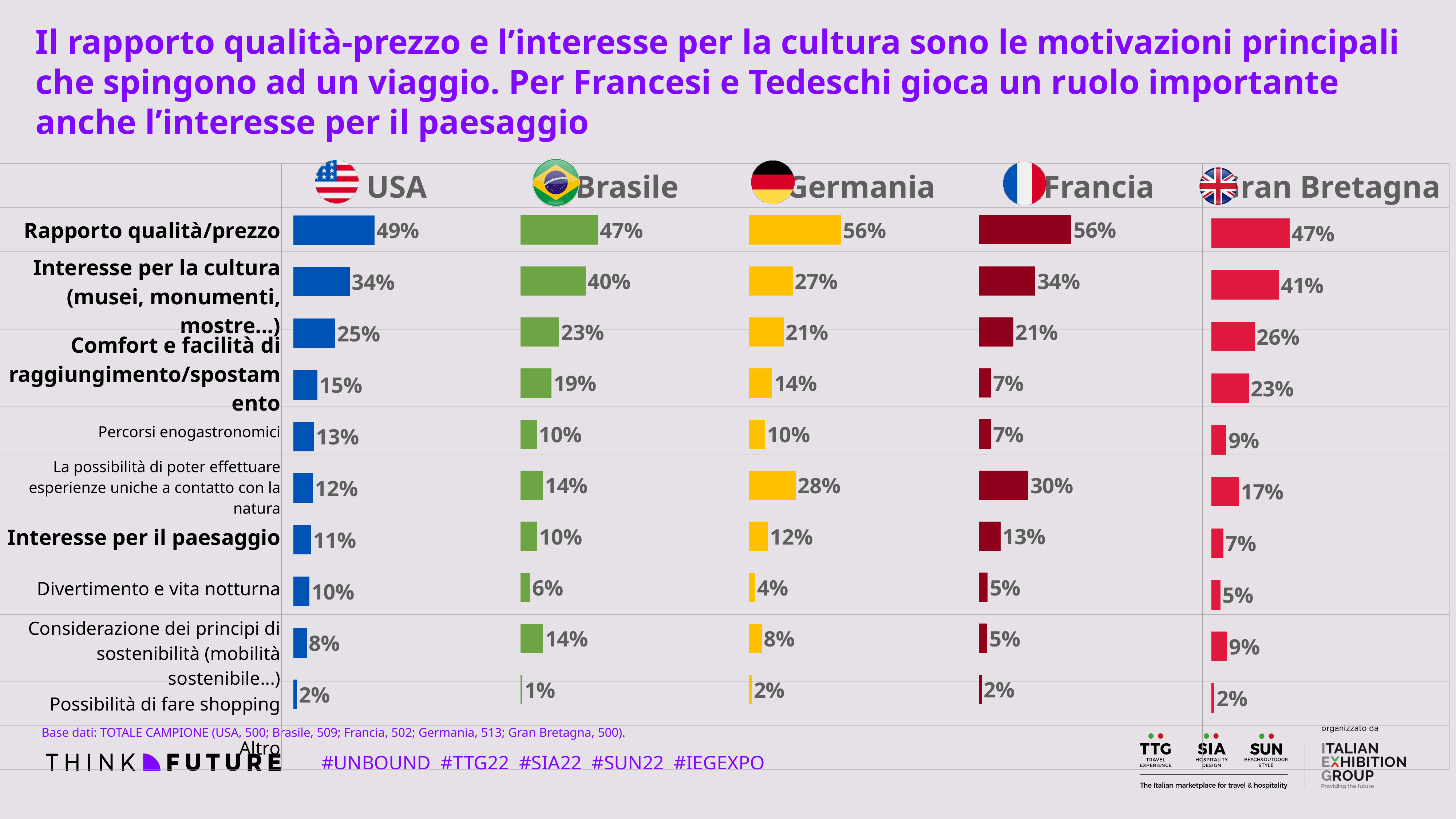
In the USA chart, what is the value for Rapporto qualità/prezzo? 49% In the Francia chart, what is the difference between Rapporto qualità/prezzo and Interesse per la cultura? 22 percentage points How many bars does the USA chart contain? 10 In the Gran Bretagna chart, what is the value for Interesse per la cultura (musei, monumenti, mostre…)? 41% In the Brasile chart, what is the value for Interesse per la cultura (musei, monumenti, mostre…)? 40% For Interesse per la cultura, which is larger: the Brasile value or the Germania value? Brasile In the Germania chart, what is the value for Rapporto qualità/prezzo? 56% In the Francia chart, which category has the highest value? Rapporto qualità/prezzo What kind of chart is used for each country on this slide? Bar chart Which two countries share the highest value for Rapporto qualità/prezzo? Germania and Francia What colour are the bars in the Germania chart? Yellow In the USA chart, what is the difference between Rapporto qualità/prezzo and Interesse per la cultura? 15 percentage points